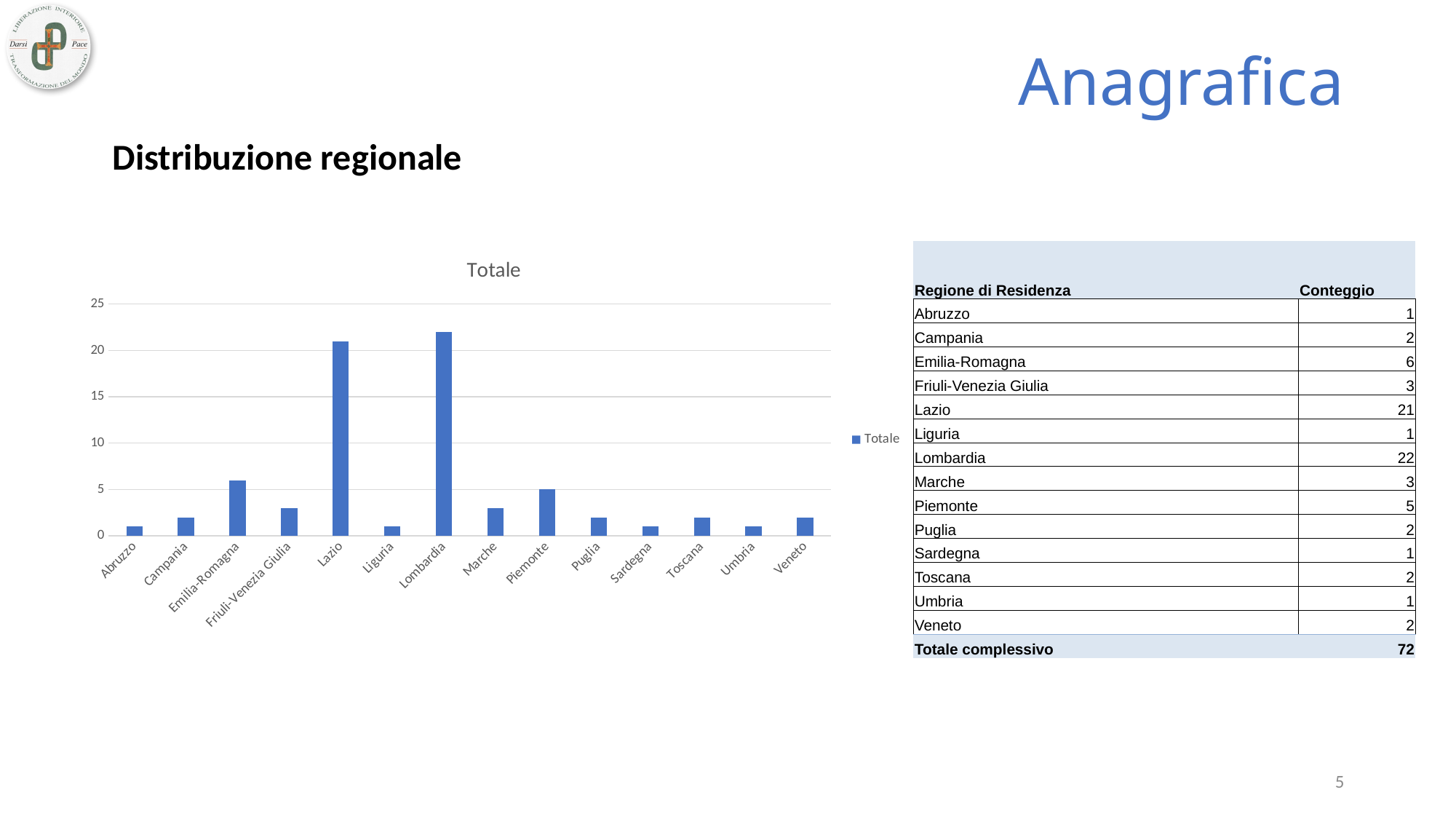
Which is larger, the value for Piemonte or the value for Marche? Piemonte How many regions are shown on the x axis of the chart? 14 What is the title of the chart? Totale What kind of chart is shown on the slide? bar chart What is the value for Lombardia? 22 Is the value for Piemonte greater or less than 10? less What is the value for Emilia-Romagna? 6 Which region has the highest bar in the chart? Lombardia What is the value for Lazio? 21 Is the value for Lazio greater or less than 20? greater How many series does the chart legend list? 1 What is the difference between the values for Lombardia and Lazio? 1